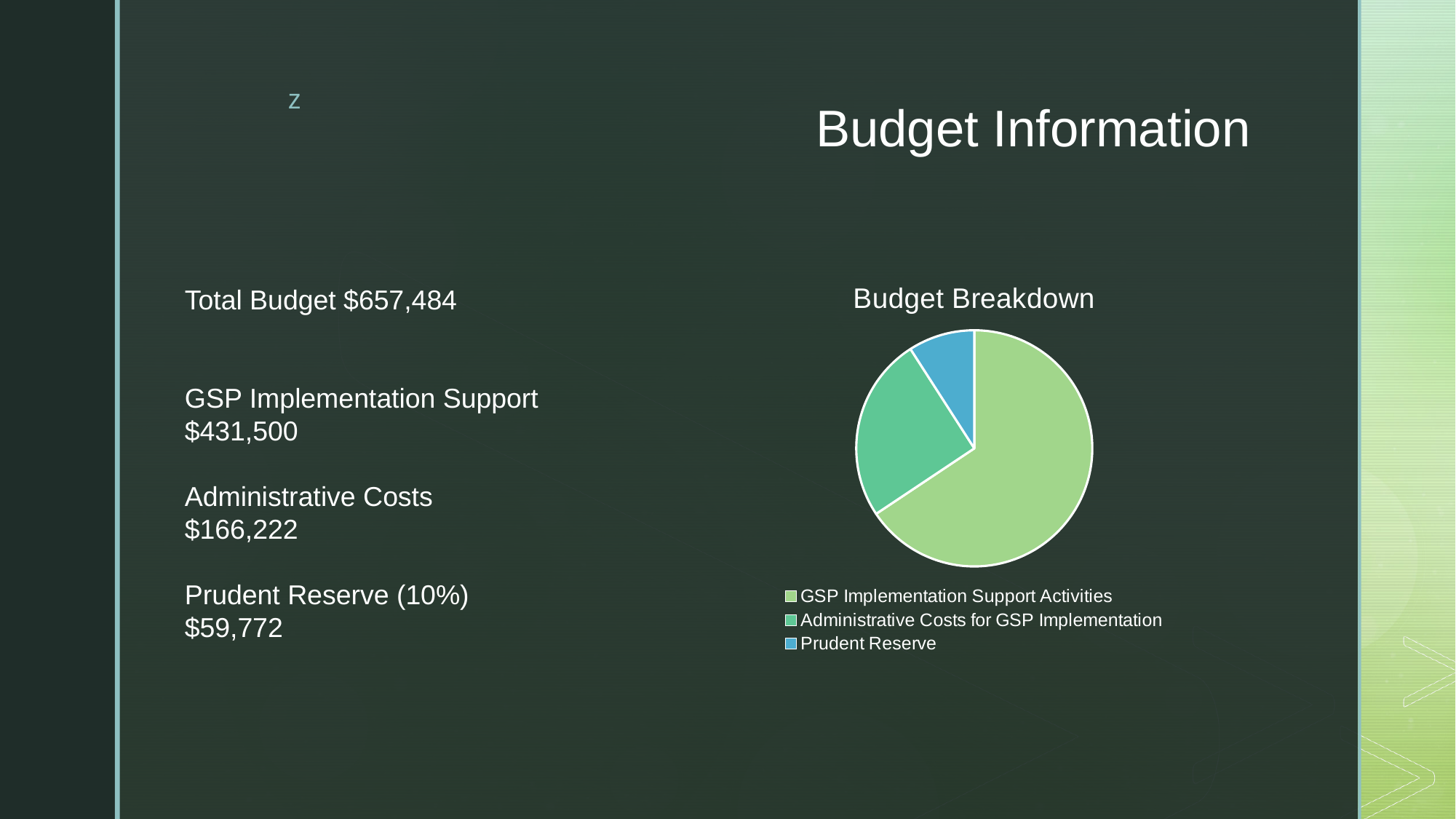
What colour is the Prudent Reserve slice in the Budget Breakdown pie chart? Blue What kind of chart is shown under the heading Budget Breakdown? Pie chart How many entries does the legend of the Budget Breakdown pie chart list? 3 What is the total budget shown on the slide? $657,484 Which category takes the largest slice of the Budget Breakdown pie chart? GSP Implementation Support Activities What is the dollar amount for the Prudent Reserve shown on the slide? $59,772 What share of the budget does the Prudent Reserve slice represent, according to the slide? 10% Which category takes the smallest slice of the Budget Breakdown pie chart? Prudent Reserve What is the dollar amount for Administrative Costs shown on the slide? $166,222 In the Budget Breakdown pie chart, which slice is larger: Administrative Costs for GSP Implementation or Prudent Reserve? Administrative Costs for GSP Implementation What is the dollar amount for GSP Implementation Support shown on the slide? $431,500 How many slices does the Budget Breakdown pie chart have? 3